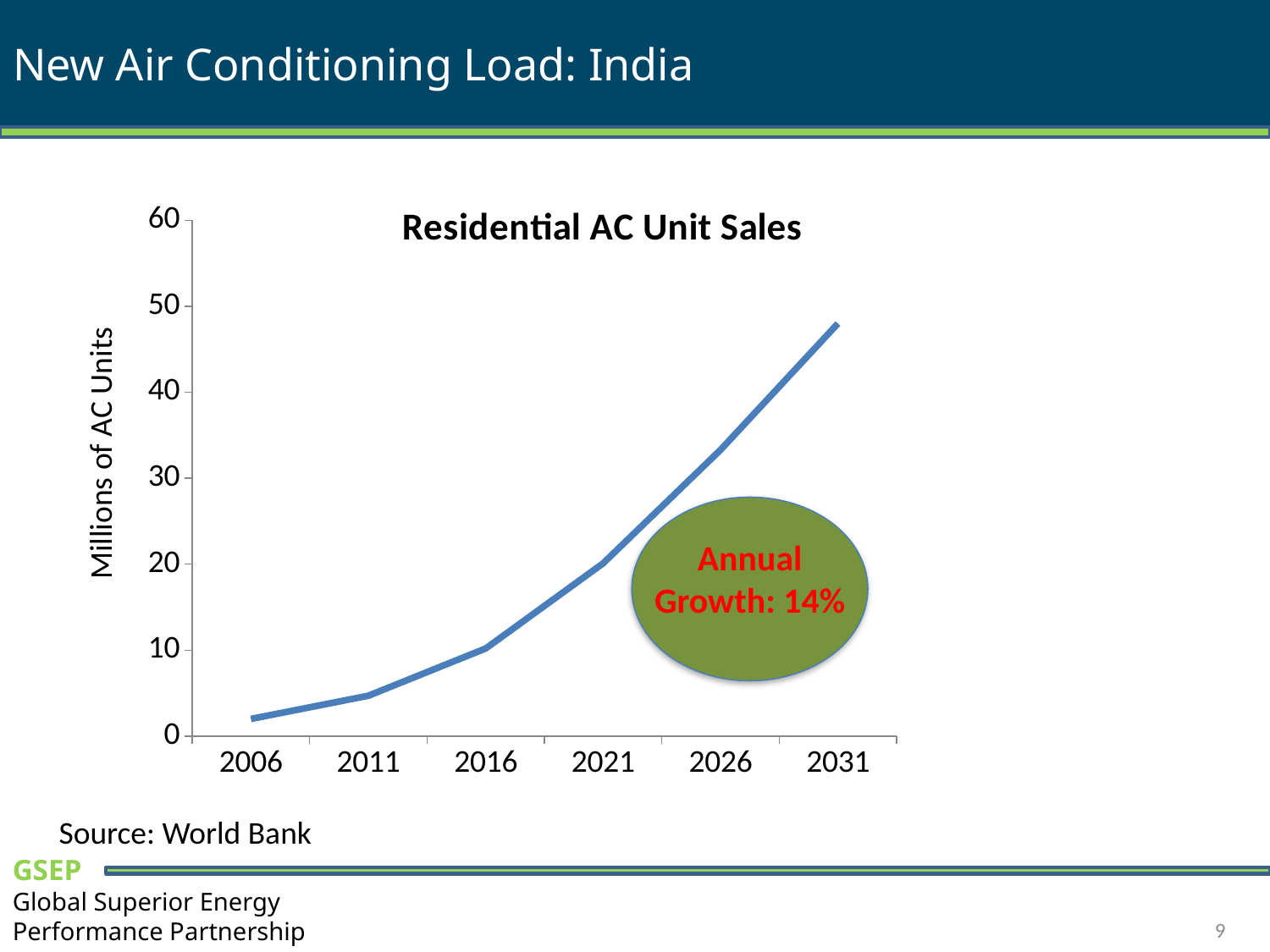
What kind of chart is shown on the slide? line chart Is the value for 2031 greater or less than 40? greater What is the label on the vertical axis of the chart? Millions of AC Units Which year has the highest value in the chart? 2031 Is the value for 2031 greater or less than 50? less Is the value for 2026 greater or less than 30? greater What is the title of the chart? Residential AC Unit Sales Which year has the lowest value in the chart? 2006 Do the values in the chart rise or fall from 2006 to 2031? rise Which year has the larger value, 2011 or 2026? 2026 How many years are labelled along the x axis of the chart? 6